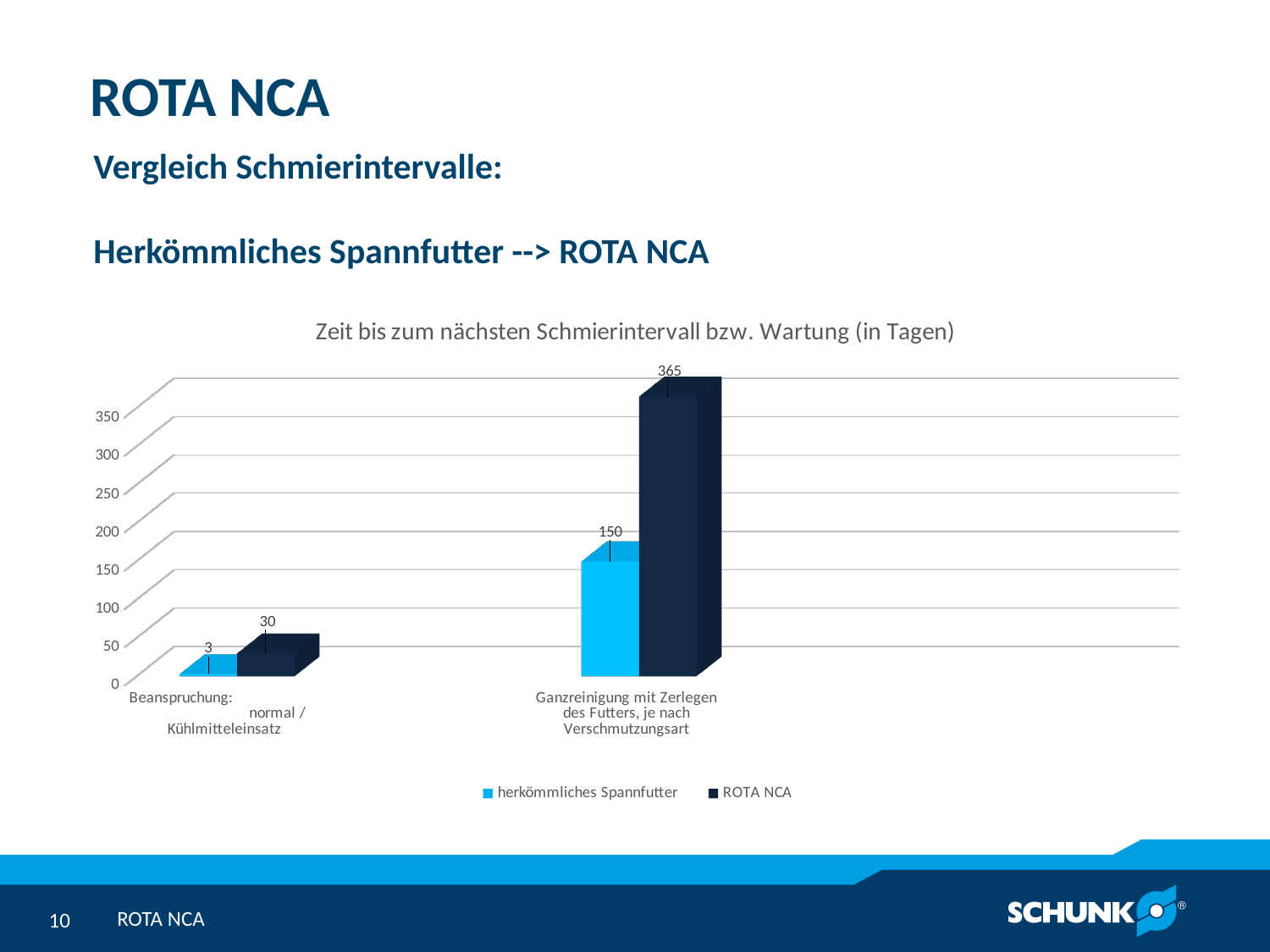
What is the value for herkömmliches Spannfutter in the category "Ganzreinigung mit Zerlegen des Futters, je nach Verschmutzungsart"? 150 Which bar has the lowest value in the chart? herkömmliches Spannfutter, Beanspruchung: normal / Kühlmitteleinsatz How many series does the chart legend list? 2 How many categories are shown on the x axis of the chart? 2 What type of chart is shown on the slide? Bar chart Which series has the highest value in the chart? ROTA NCA What is the value for ROTA NCA in the category "Beanspruchung: normal / Kühlmitteleinsatz"? 30 What is the difference between ROTA NCA and herkömmliches Spannfutter in the category "Ganzreinigung mit Zerlegen des Futters, je nach Verschmutzungsart"? 215 What is the difference between ROTA NCA and herkömmliches Spannfutter in the category "Beanspruchung: normal / Kühlmitteleinsatz"? 27 What is the value for herkömmliches Spannfutter in the category "Beanspruchung: normal / Kühlmitteleinsatz"? 3 Which is larger in the category "Beanspruchung: normal / Kühlmitteleinsatz": herkömmliches Spannfutter or ROTA NCA? ROTA NCA What is the value for ROTA NCA in the category "Ganzreinigung mit Zerlegen des Futters, je nach Verschmutzungsart"? 365